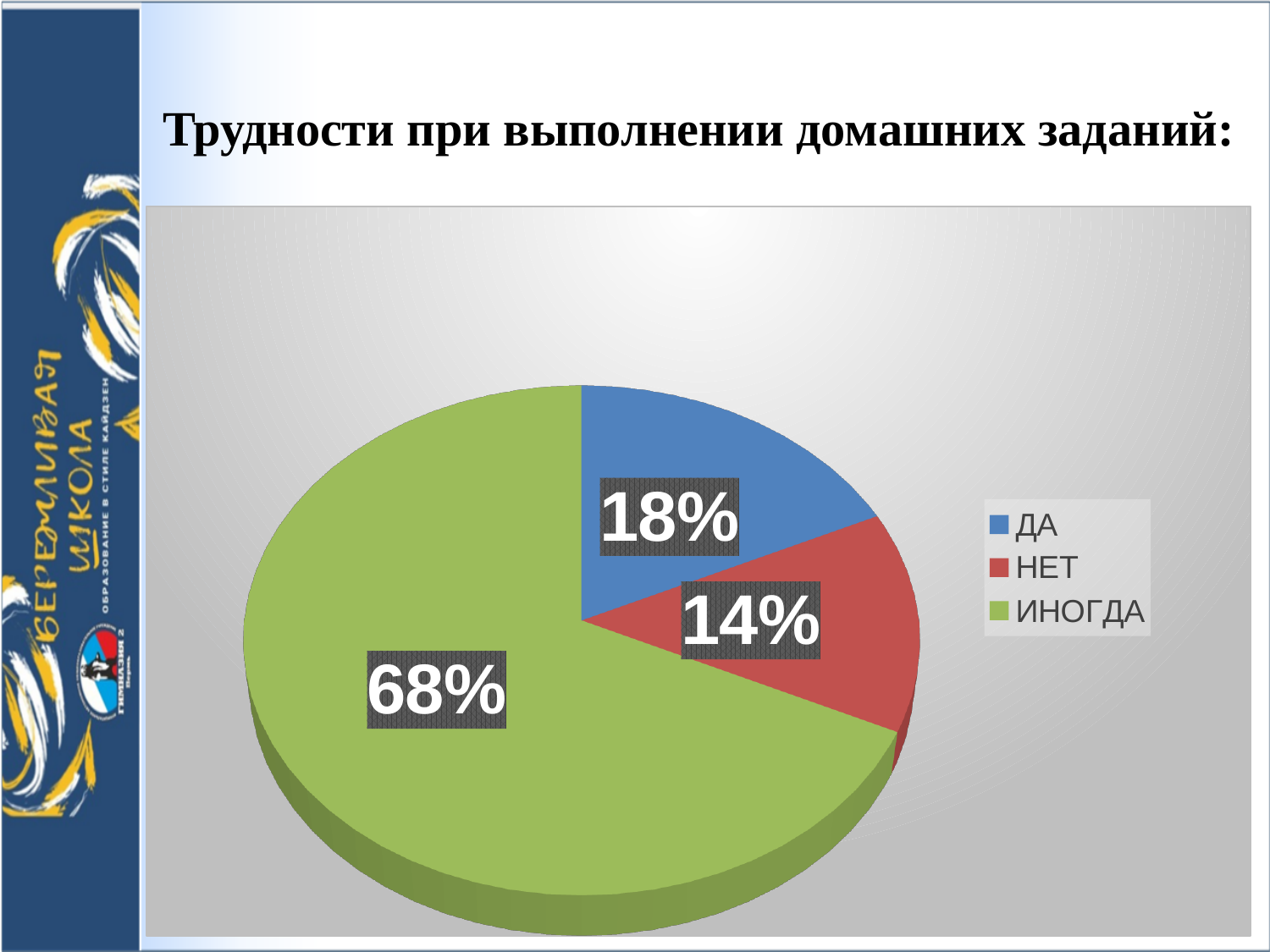
What colour is the slice for ИНОГДА? green How many slices does the pie chart have? 3 What type of chart is shown on the slide? pie chart What percentage is shown for ИНОГДА? 68% Which category has the smallest share of the pie? НЕТ Which is larger, the share for ДА or the share for НЕТ? ДА What is the difference in percentage points between ДА and НЕТ? 4 What is the difference in percentage points between ИНОГДА and ДА? 50 What percentage is shown for ДА? 18% Which category has the largest share of the pie? ИНОГДА What percentage is shown for НЕТ? 14% How many entries does the legend list? 3